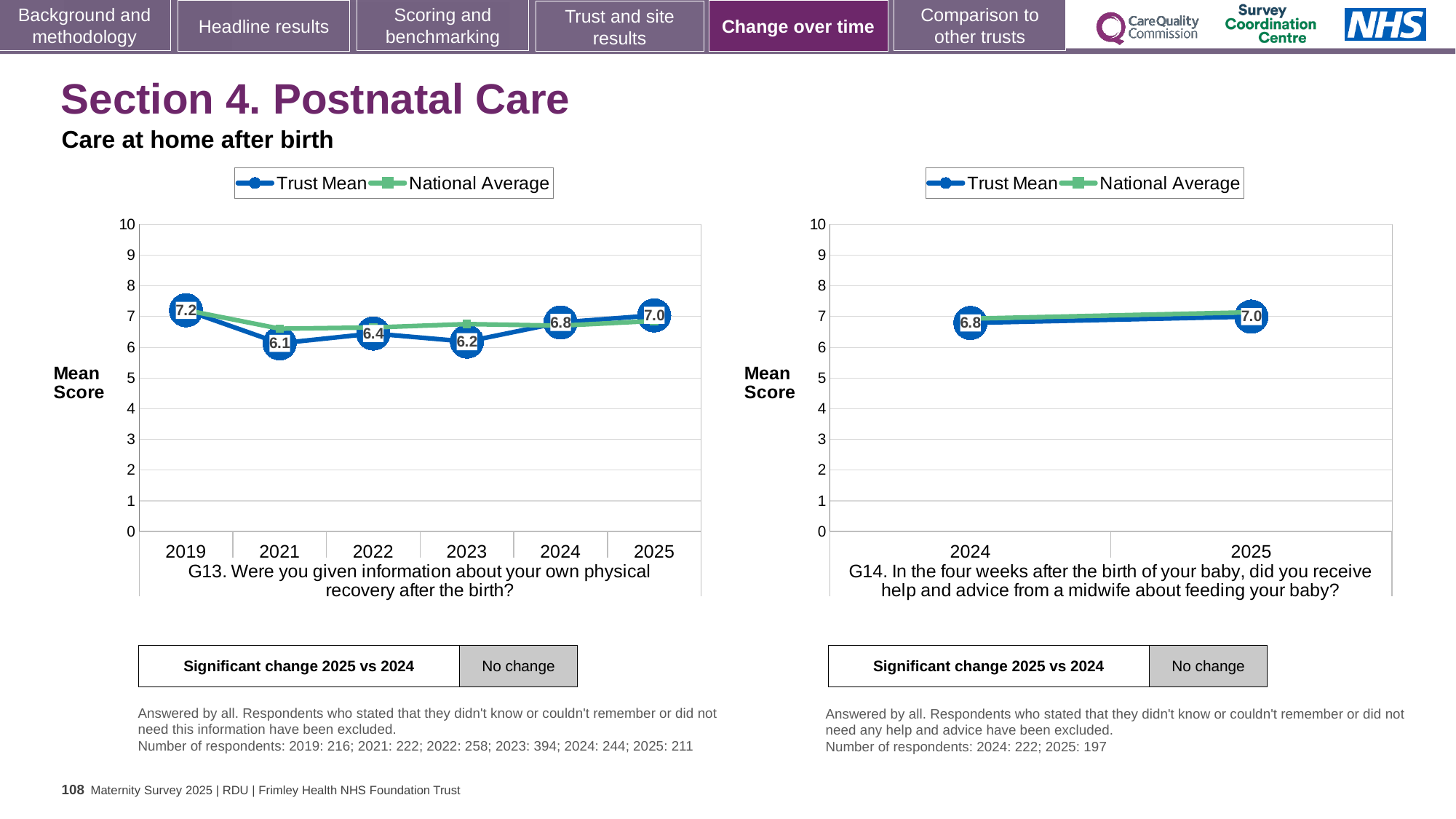
In the G14 chart on the right, what is the Trust Mean score for 2025? 7.0 In the G13 chart on the left, which year has the lowest Trust Mean score? 2021 In the G13 chart on the left, what is the Trust Mean score for 2019? 7.2 In the G14 chart on the right, what is the difference between the Trust Mean scores for 2025 and 2024? 0.2 In the G13 chart on the left, what is the difference between the Trust Mean scores for 2019 and 2021? 1.1 In the G13 chart on the left, is the National Average for 2021 greater or less than 7? less In the G13 chart on the left, what is the Trust Mean score for 2023? 6.2 What type of chart is the G14 chart on the right? Line chart In the G13 chart on the left, which year has the highest Trust Mean score? 2019 How many years are shown on the x axis of the G13 chart on the left? 6 In the G13 chart on the left, is the Trust Mean score higher in 2022 or in 2024? 2024 How many series does the legend of the G14 chart on the right list? 2